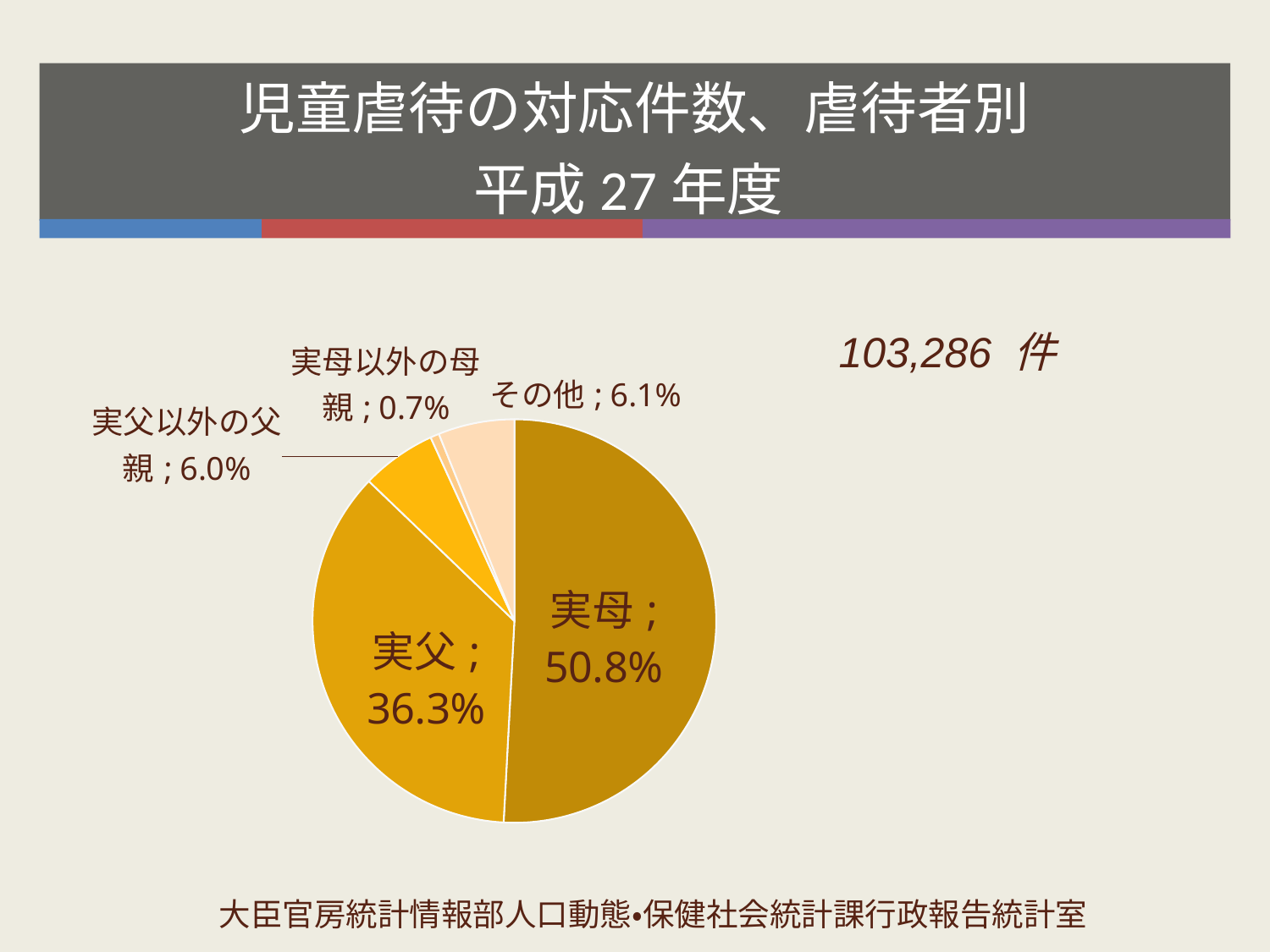
What total number of cases is printed on the slide next to the chart? 103,286 件 What is the difference in percentage points between the 実母 share and the 実父 share? 14.5 What share of the pie does 実父 account for? 36.3% What kind of chart is shown on the slide? pie chart Which category has the smallest slice of the pie? 実母以外の母親 What is the value shown for 実父以外の父親? 6.0% How many slices does the pie chart have? 5 What share of the pie does 実母 account for? 50.8% Which category has the largest slice of the pie? 実母 What is the value shown for その他? 6.1% What is the value shown for 実母以外の母親? 0.7% Which is larger, the share for 実母 or the share for 実父? 実母